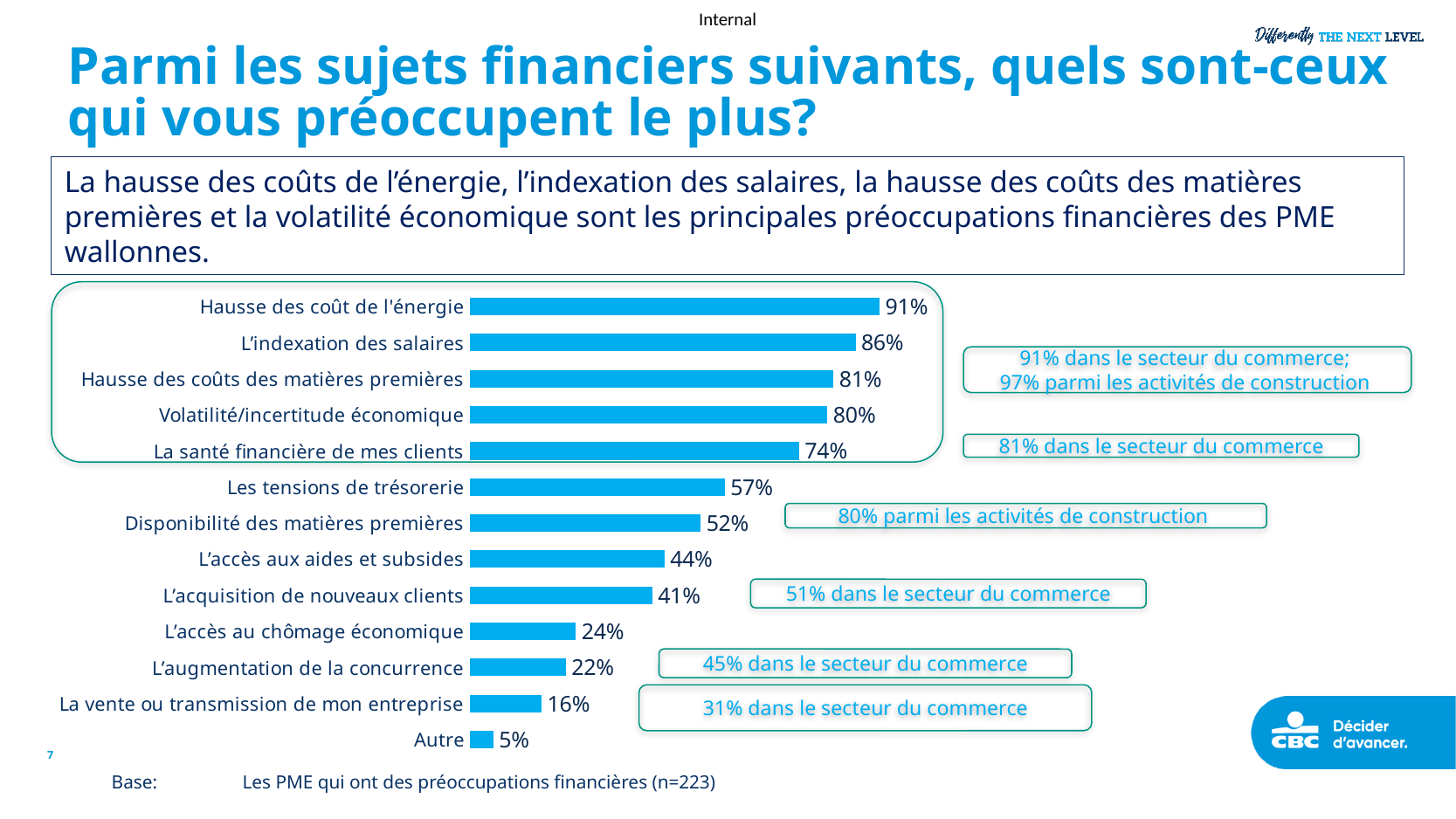
What is the value for "L'accès au chômage économique"? 24% How many categories are shown in the chart? 13 What is the difference between "La santé financière de mes clients" and "L'acquisition de nouveaux clients"? 33% What is the value for "Les tensions de trésorerie"? 57% What is the value for "Hausse des coût de l'énergie"? 91% Which is larger: "Disponibilité des matières premières" or "L'accès aux aides et subsides"? Disponibilité des matières premières What is the difference between "L'indexation des salaires" and "Volatilité/incertitude économique"? 6% What is the base (n) stated below the chart? n=223 Which category has the highest value? Hausse des coût de l'énergie Which category has the lowest value? Autre What kind of chart is shown on the slide? Bar chart What is the value for "La vente ou transmission de mon entreprise"? 16%